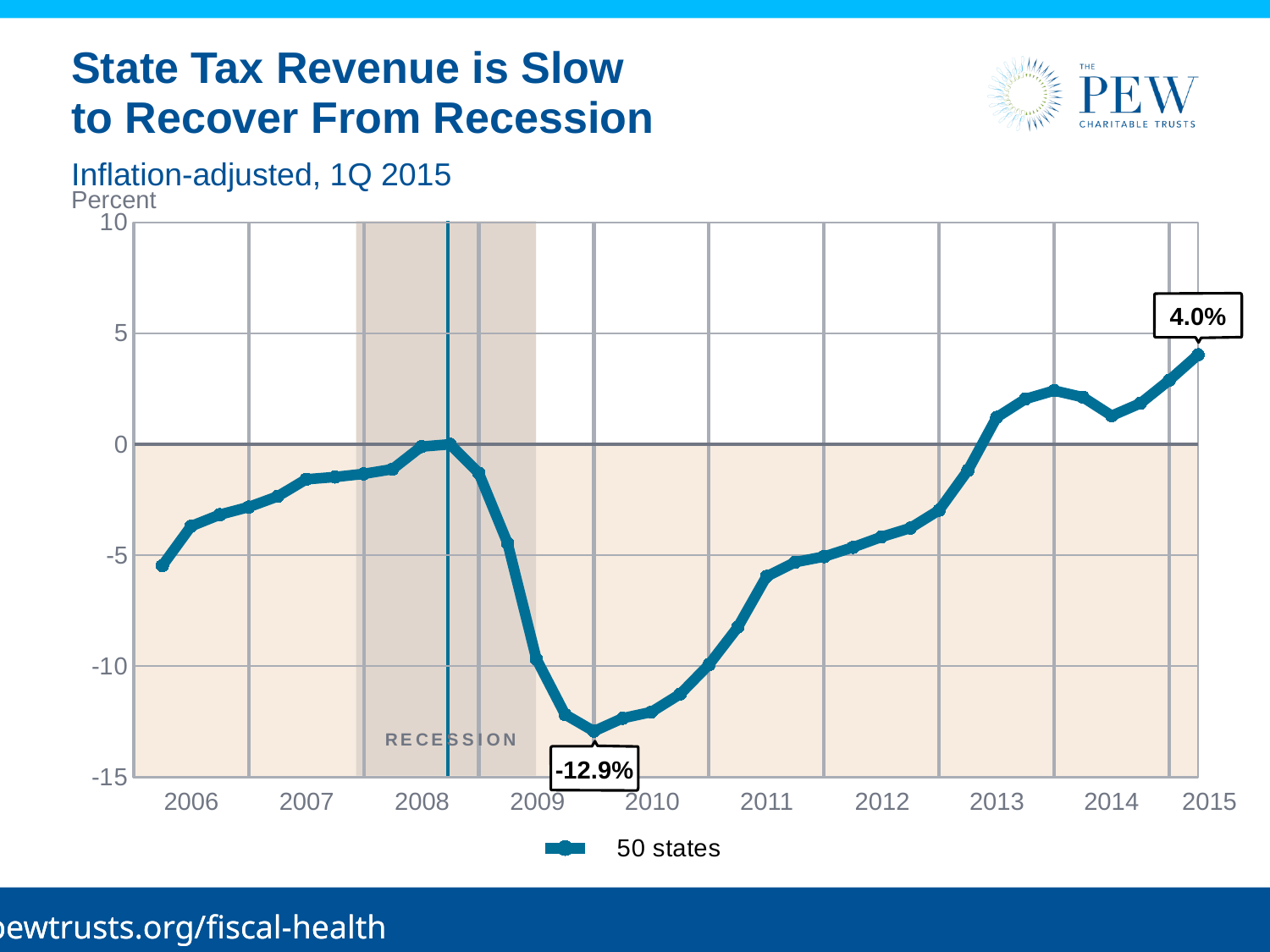
Is the value for 2011 greater or less than -5? less What is the difference between the highest labelled value (4.0%) and the lowest labelled value (-12.9%)? 16.9 percentage points How many series does the legend list? 1 In which year does the 50 states line reach its lowest value? 2010 Does the line rise or fall between 2010 and 2015? rise What is the value of the 50 states line at the final point in 2015? 4.0% What kind of chart is shown on the slide? line chart What is the lowest value reached by the 50 states line? -12.9% What label is shown on the shaded region between 2007 and 2009? RECESSION Which is larger, the value at 2006 or the value at 2015? 2015 Is the value for 2010 greater or less than -10? less